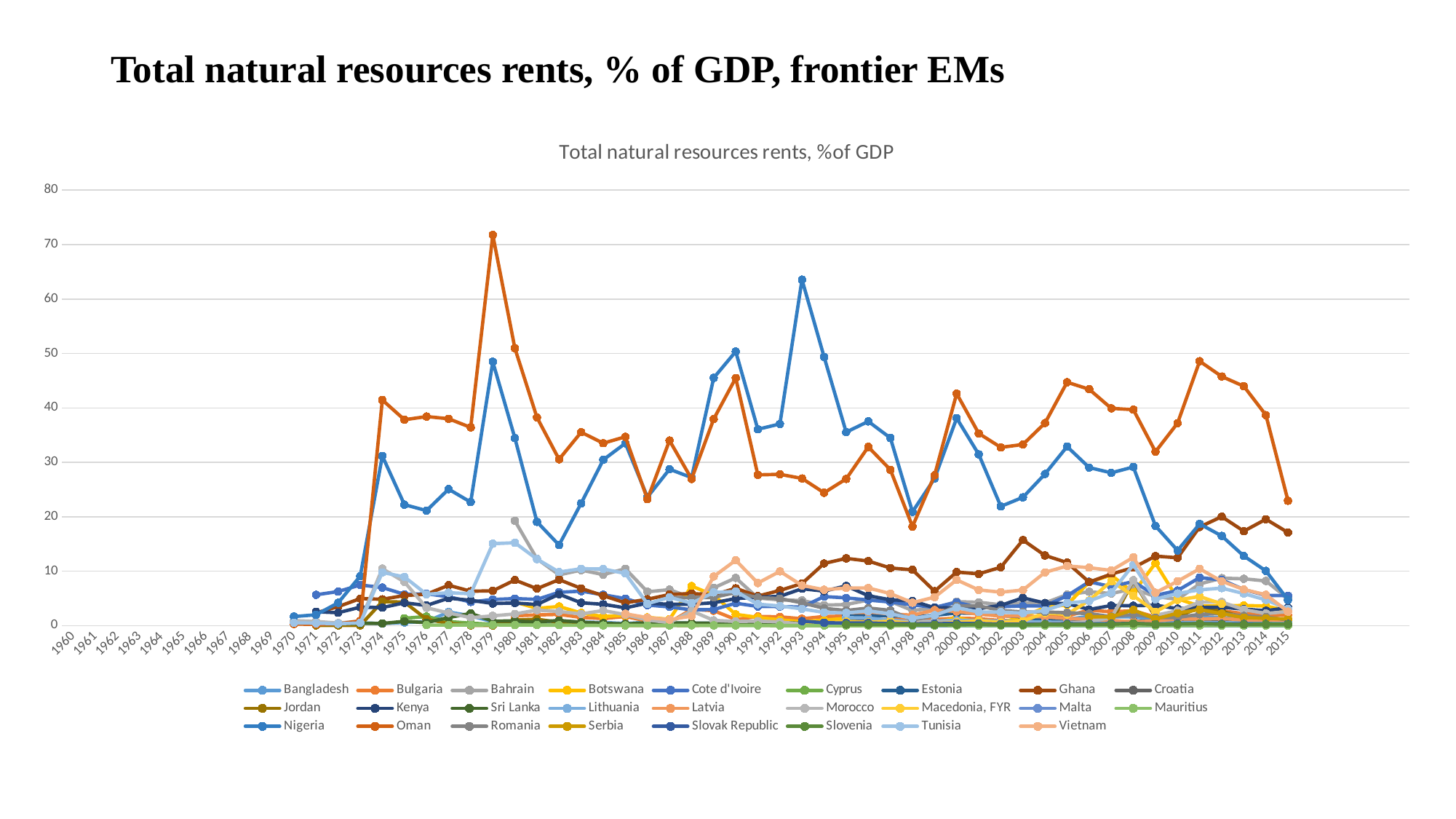
In which year does Oman reach its highest value? 1979 Does the value for Oman rise or fall from 2011 to 2015? fall Which is larger in 2015, the value for Oman or the value for Nigeria? Oman What kind of chart is shown on the slide? line chart Which series reaches the highest value on the chart? Oman Which is larger in 1993, the value for Nigeria or the value for Oman? Nigeria How many years are shown on the x axis? 56 In which year does Nigeria reach its highest value? 1993 How many series does the legend list? 26 Is the value for Nigeria in 1993 greater or less than 60? greater Is the value for Oman in 1979 greater or less than 60? greater Is the value for Oman in 2015 greater or less than 30? less